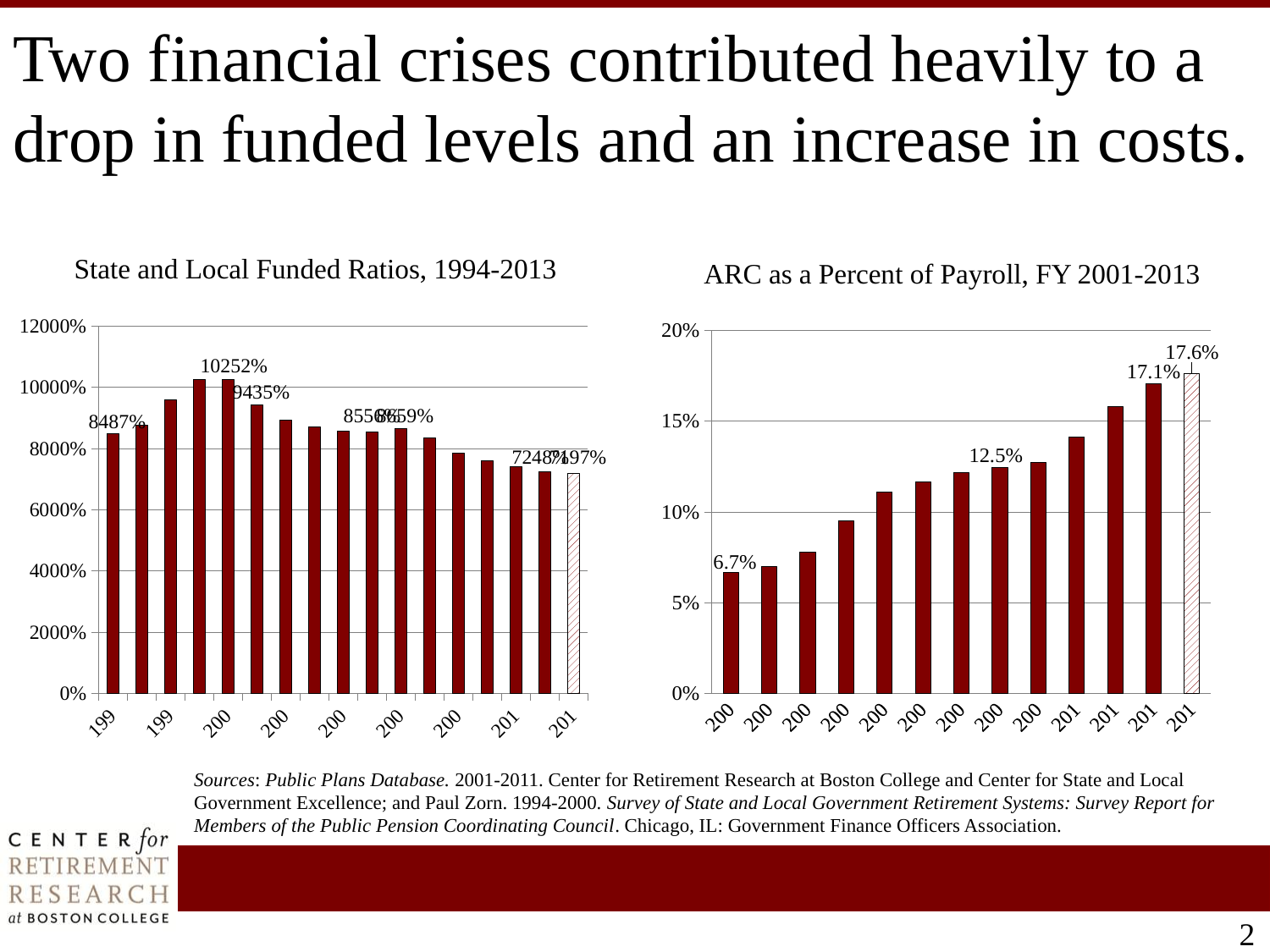
How many bars are plotted in the right chart, 'ARC as a Percent of Payroll, FY 2001-2013'? 13 In the left chart, 'State and Local Funded Ratios, 1994-2013', what is the data label on the last (hatched) bar? 7197% In the right chart, 'ARC as a Percent of Payroll, FY 2001-2013', what is the difference between the highest labeled value (17.6%) and the lowest labeled value (6.7%)? 10.9% What kind of chart is the left chart, 'State and Local Funded Ratios, 1994-2013'? bar chart In the right chart, 'ARC as a Percent of Payroll, FY 2001-2013', is the value of the third bar from the left greater or less than 10%? less In the right chart, 'ARC as a Percent of Payroll, FY 2001-2013', what is the difference between the last bar (17.6%) and the bar before it (17.1%)? 0.5% In the left chart, 'State and Local Funded Ratios, 1994-2013', what is the data label on the first bar? 8487% In the right chart, 'ARC as a Percent of Payroll, FY 2001-2013', what is the lowest labeled value? 6.7% In the left chart, 'State and Local Funded Ratios, 1994-2013', what is the highest labeled value? 10252% In the right chart, 'ARC as a Percent of Payroll, FY 2001-2013', what is the highest labeled value? 17.6% In the right chart, 'ARC as a Percent of Payroll, FY 2001-2013', which is larger: the bar labeled 17.1% or the bar labeled 12.5%? 17.1% In the right chart, 'ARC as a Percent of Payroll, FY 2001-2013', do the values generally rise or fall from left to right? rise